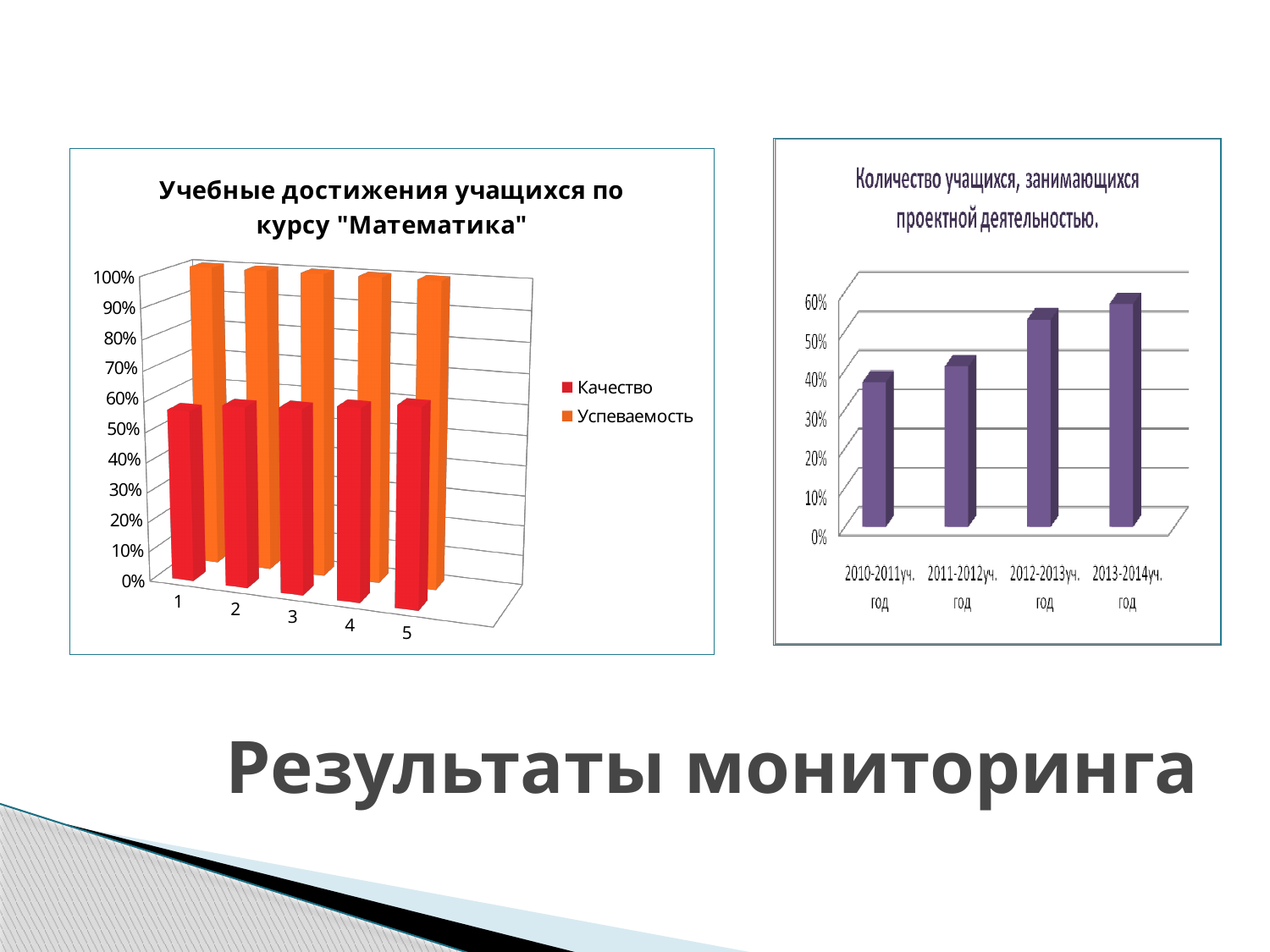
What kind of chart is the right chart titled "Количество учащихся, занимающихся проектной деятельностью"? bar chart How many series does the legend of the left chart ("Учебные достижения учащихся по курсу "Математика"") list? 2 In the right chart ("Количество учащихся, занимающихся проектной деятельностью"), which school year has the highest value? 2013-2014 уч. год In the left chart ("Учебные достижения учащихся по курсу "Математика""), is the Качество value for category 3 greater or less than 70%? less What kind of chart is the left chart titled "Учебные достижения учащихся по курсу "Математика""? bar chart In the right chart ("Количество учащихся, занимающихся проектной деятельностью"), how many school years are shown on the x axis? 4 In the right chart ("Количество учащихся, занимающихся проектной деятельностью"), which school year has the lowest value? 2010-2011 уч. год In the left chart ("Учебные достижения учащихся по курсу "Математика""), is the Успеваемость value for category 5 greater or less than 80%? greater In the left chart ("Учебные достижения учащихся по курсу "Математика""), which series is larger for category 1, Качество or Успеваемость? Успеваемость In the left chart ("Учебные достижения учащихся по курсу "Математика""), how many categories are shown on the x axis? 5 In the left chart ("Учебные достижения учащихся по курсу "Математика""), what colour are the Качество bars? red In the right chart ("Количество учащихся, занимающихся проектной деятельностью"), do the values rise or fall from 2010-2011 to 2013-2014? rise